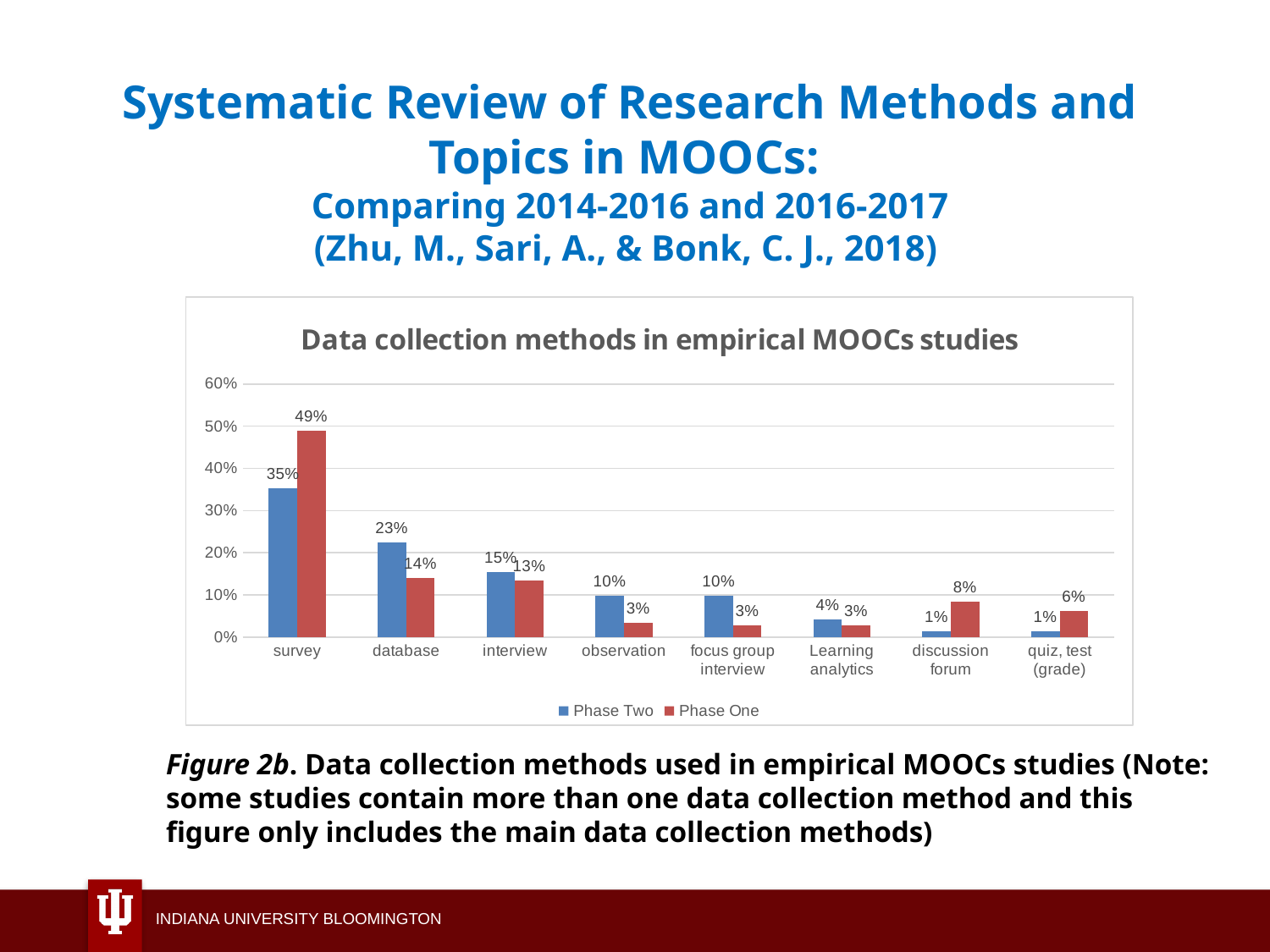
What is the difference between the Phase One and Phase Two values for survey? 14% What kind of chart is shown? bar chart What is the Phase Two value for database? 23% How many series does the legend list? 2 What is the title of the chart? Data collection methods in empirical MOOCs studies Which is larger for discussion forum: Phase Two or Phase One? Phase One Which data collection method has the lowest Phase One value? observation, focus group interview, Learning analytics (3%) How many data collection methods are shown on the x axis? 8 Which data collection method has the highest Phase Two value? survey Is the Phase Two value for survey greater or less than 30%? greater What is the Phase One value for quiz, test (grade)? 6% What is the Phase One value for survey? 49%